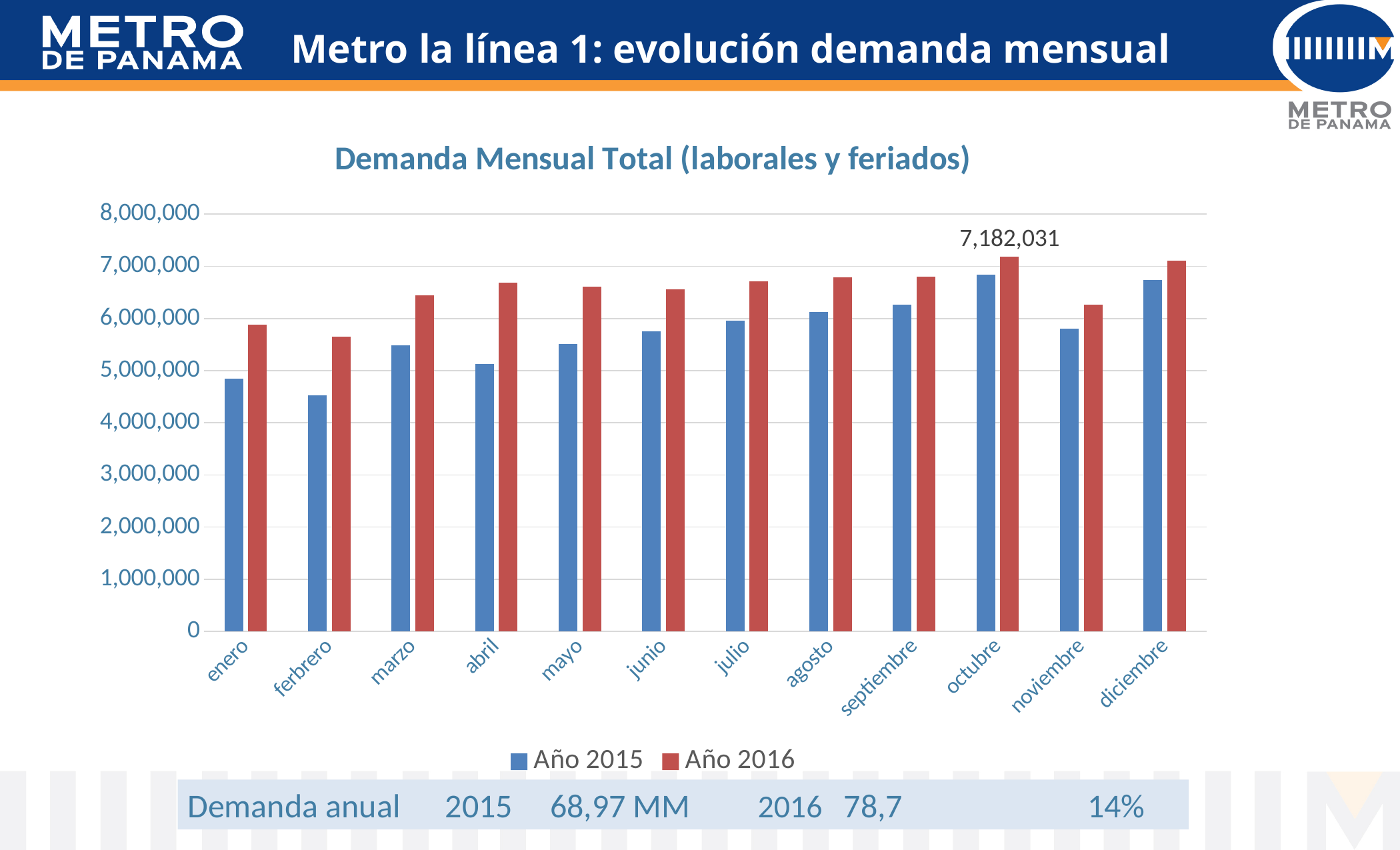
How many months are shown on the x axis? 12 Is the value for Año 2015 in enero greater or less than 5,000,000? less In enero, which series has the larger value, Año 2015 or Año 2016? Año 2016 Which month has the lowest value for Año 2015? ferbrero Is the value for Año 2016 in marzo greater or less than 6,000,000? greater Which month has the lowest value for Año 2016? ferbrero Which month has the highest value for Año 2016? octubre How many series does the legend list? 2 For Año 2015, which is larger, marzo or abril? marzo What kind of chart is shown? bar chart Is the value for Año 2015 in noviembre greater or less than 6,000,000? less What is the value for Año 2016 in octubre? 7,182,031